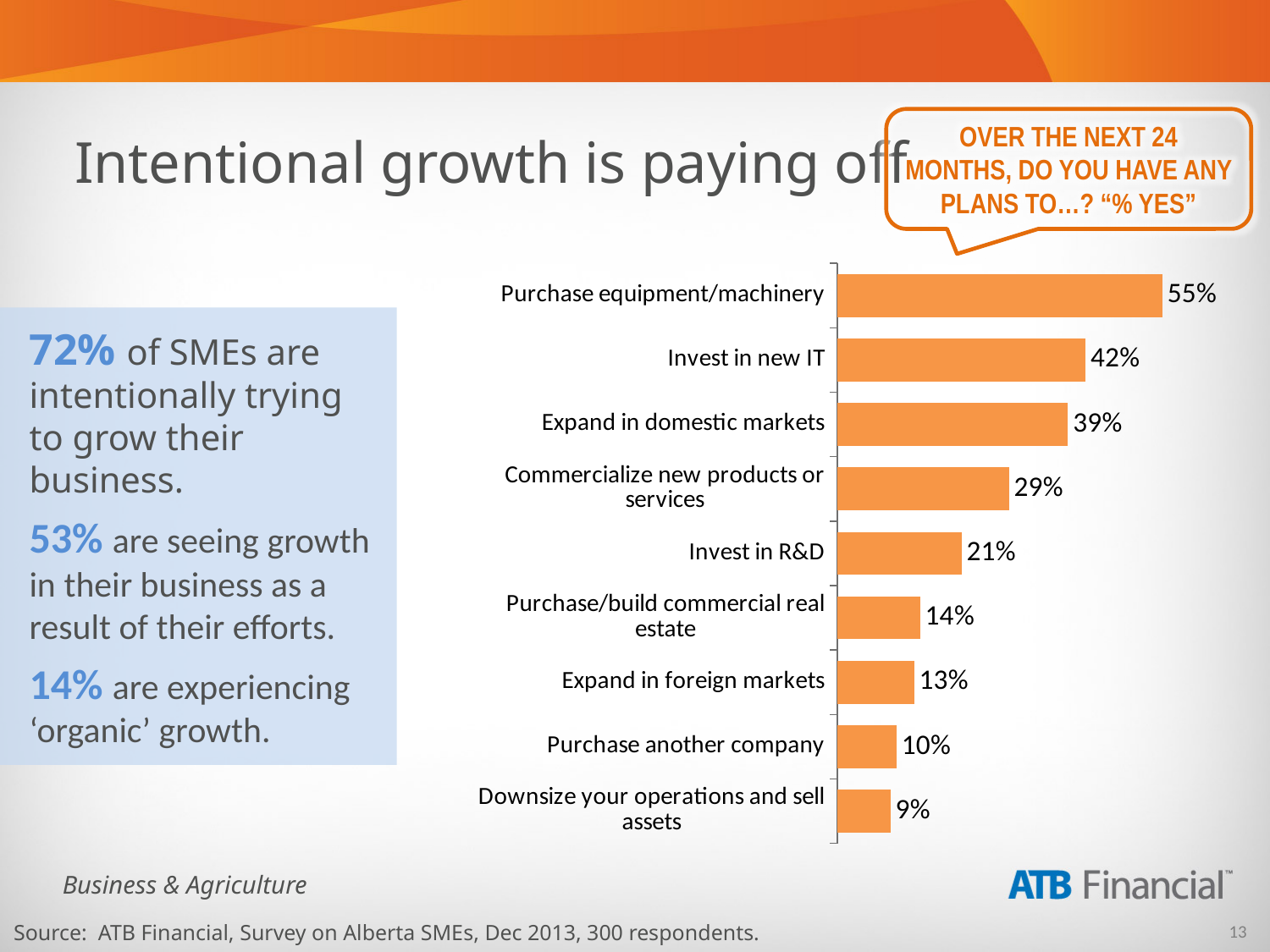
Do the values increase or decrease going from the top bar to the bottom bar? Decrease What percentage of respondents plan to purchase equipment/machinery over the next 24 months? 55% Which is larger: the value for 'Commercialize new products or services' or the value for 'Invest in R&D'? Commercialize new products or services What type of chart is shown on the slide? Bar chart Which category has the lowest value in the chart? Downsize your operations and sell assets Which category has the highest value in the chart? Purchase equipment/machinery What survey question is shown in the callout above the chart? Over the next 24 months, do you have any plans to...? "% yes" What is the difference between the values for 'Invest in new IT' and 'Expand in domestic markets'? 3% What percentage plan to expand in foreign markets? 13% What is the value shown for 'Invest in R&D'? 21% What is the difference between 'Purchase equipment/machinery' and 'Purchase another company'? 45% How many categories are shown in the bar chart? 9